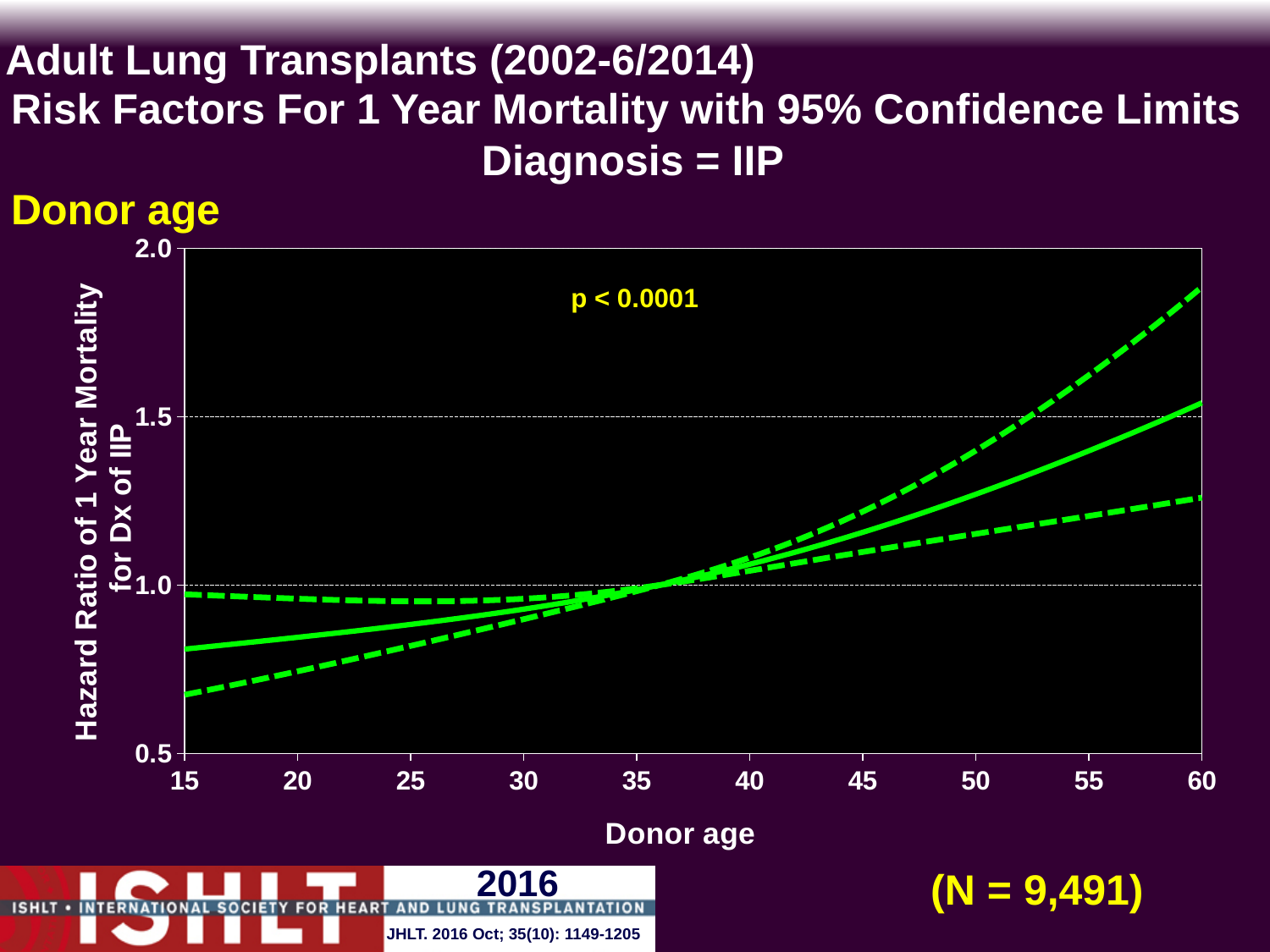
Is the lower confidence limit (lower dashed line) at donor age 60 greater or less than 1.5? less Does the hazard ratio (solid line) rise or fall as donor age increases from 15 to 60? rise How many lines are plotted on the chart? 3 Is the hazard ratio (solid line) at donor age 45 greater or less than 1.0? greater What is the label of the x axis? Donor age Is the upper confidence limit (upper dashed line) at donor age 60 greater or less than 1.5? greater What kind of chart is shown on the slide? line chart What p-value is printed on the chart? p < 0.0001